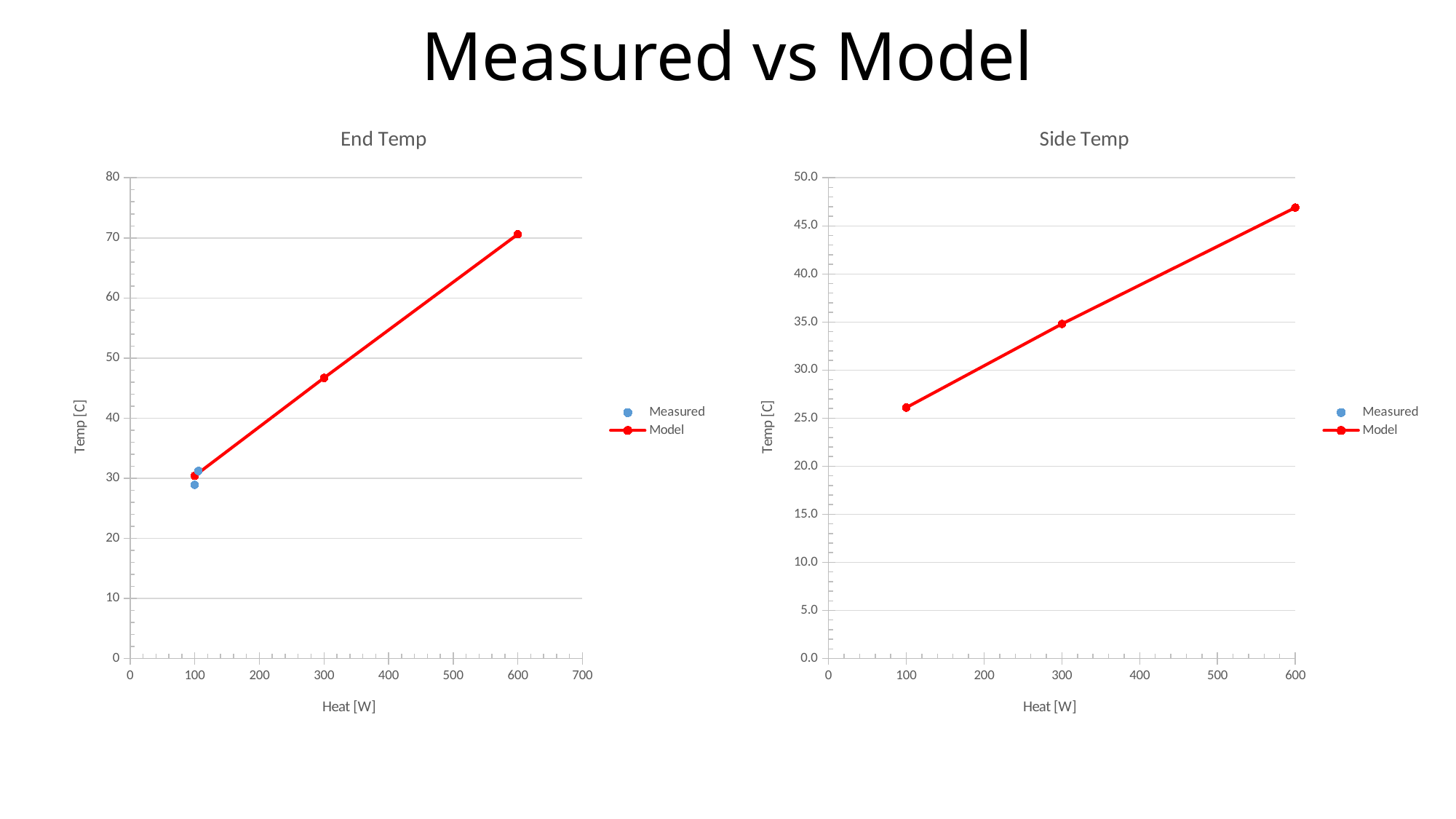
What kind of chart is the End Temp chart? scatter chart How many series does the legend of the Side Temp chart list? 2 In the Side Temp chart, is the Model value at 100 W greater or less than 30.0? less In the Side Temp chart, does the Model temperature rise or fall as Heat increases? rise In the End Temp chart, is the Model value at 300 W greater or less than 40? greater What is the x-axis label of the End Temp chart? Heat [W] In the End Temp chart, how many Model data points are plotted? 3 In the End Temp chart, is the Model value at 600 W greater or less than 60? greater In the Side Temp chart, how many Model data points are plotted? 3 In the Side Temp chart, at which Heat value is the Model temperature highest? 600 In the End Temp chart, does the Model temperature rise or fall as Heat increases? rise